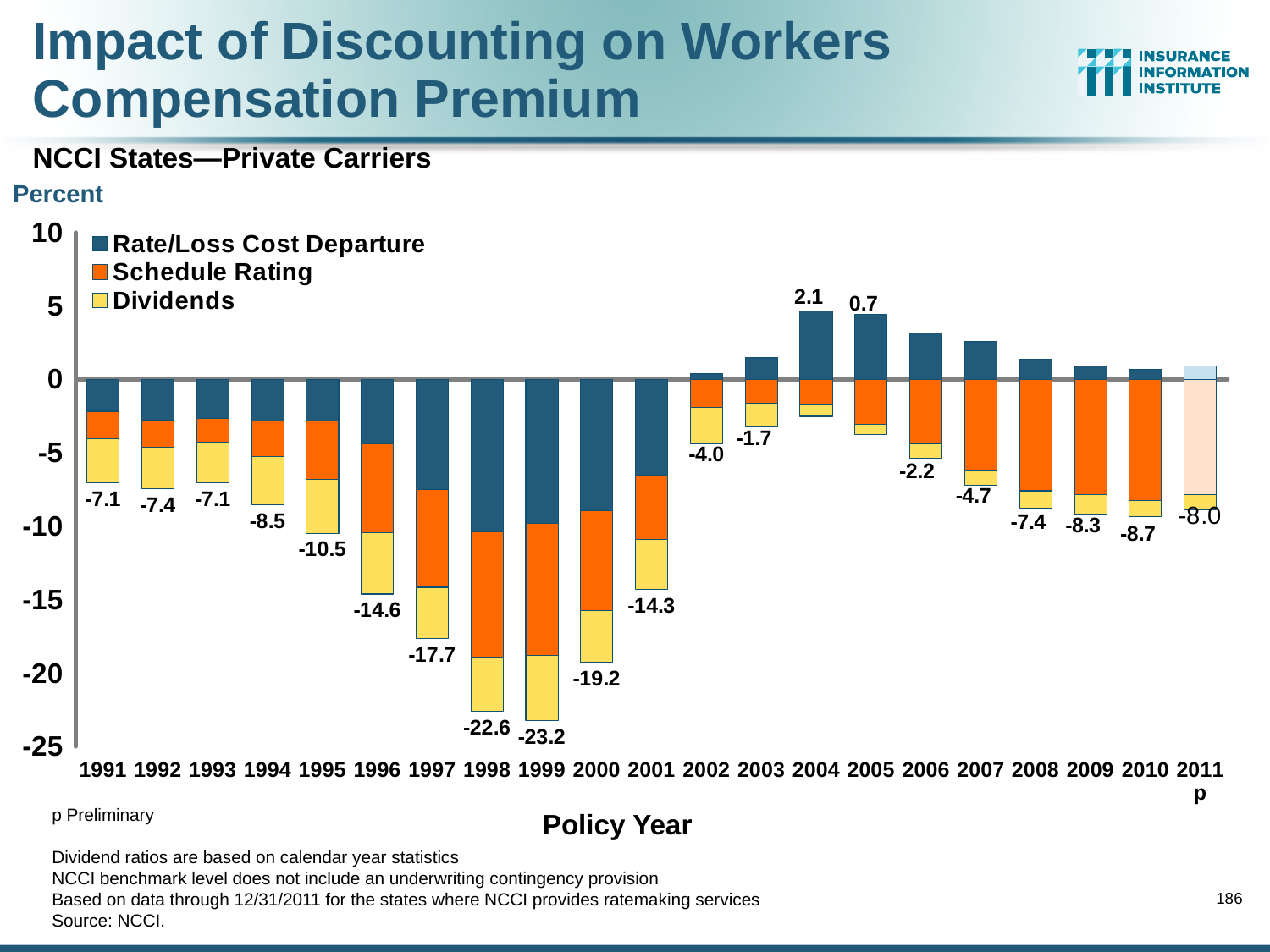
What type of chart is shown on the slide? Stacked bar chart What is the labeled value for policy year 2011p? -8.0 What is the labeled value for policy year 1996? -14.6 Which policy year has the highest labeled value? 2004 Which policy year has the lowest labeled value? 1999 Which policy year has a higher labeled value, 2005 or 2006? 2005 How many policy years are shown on the x axis? 21 What is the difference between the labeled values for 1998 and 1999? 0.6 What is the labeled value for policy year 2004? 2.1 How many series does the legend list? 3 What is the labeled value for policy year 1999? -23.2 Is the Rate/Loss Cost Departure value for 1999 greater or less than -5? less